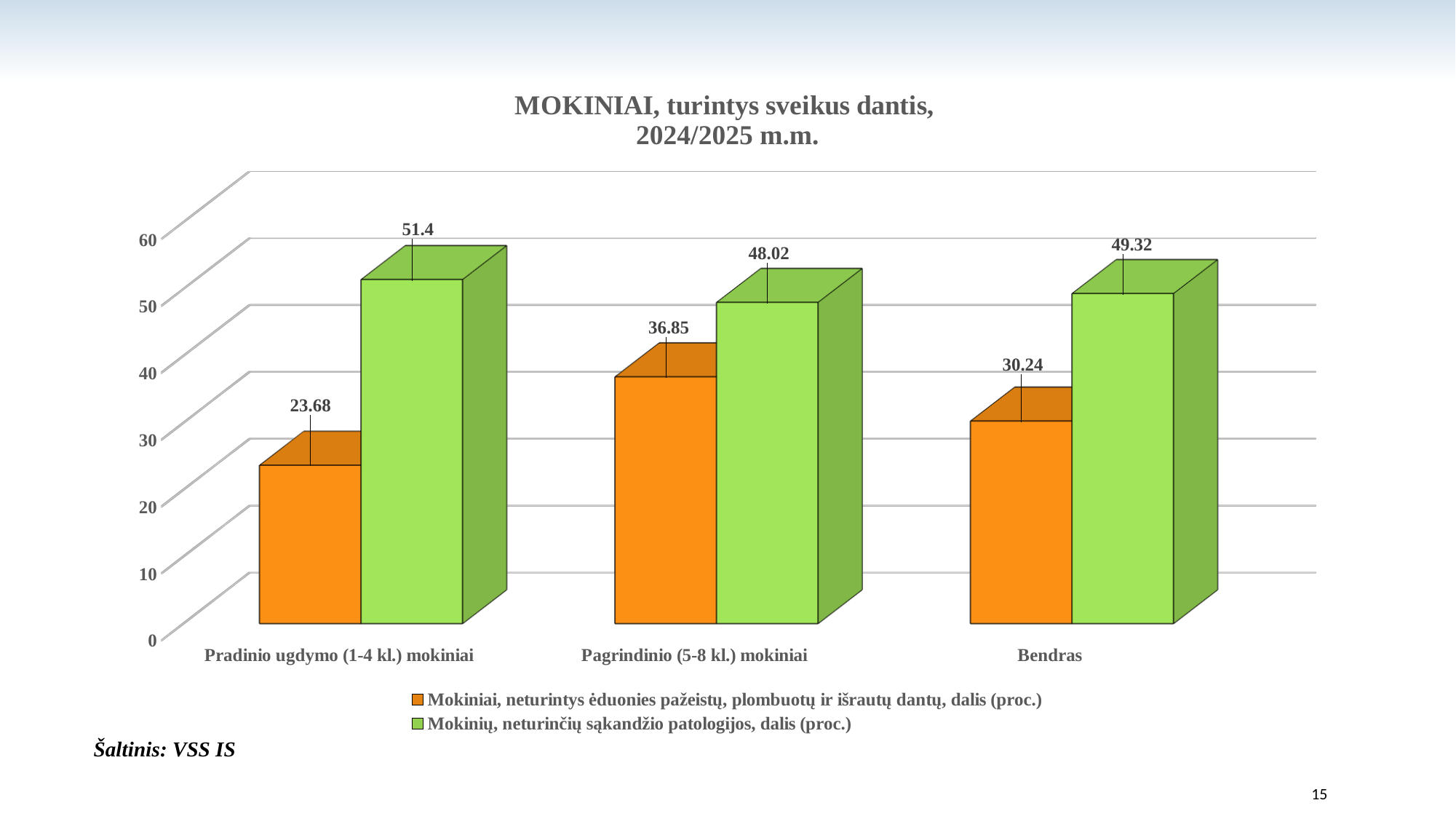
How many categories are shown on the x axis? 3 What is the difference between the 'Mokinių, neturinčių sąkandžio patologijos' values for Pradinio ugdymo (1-4 kl.) mokiniai and Pagrindinio (5-8 kl.) mokiniai? 3.38 What is the difference between the two series values for Pradinio ugdymo (1-4 kl.) mokiniai? 27.72 Which category has the lowest value in the series 'Mokiniai, neturintys ėduonies pažeistų, plombuotų ir išrautų dantų, dalis (proc.)'? Pradinio ugdymo (1-4 kl.) mokiniai What is the title of the chart? MOKINIAI, turintys sveikus dantis, 2024/2025 m.m. What kind of chart is shown on the slide? Bar chart Which category has the highest value in the series 'Mokinių, neturinčių sąkandžio patologijos, dalis (proc.)'? Pradinio ugdymo (1-4 kl.) mokiniai What is the value for Pagrindinio (5-8 kl.) mokiniai in the series 'Mokiniai, neturintys ėduonies pažeistų, plombuotų ir išrautų dantų, dalis (proc.)'? 36.85 What is the value for Pradinio ugdymo (1-4 kl.) mokiniai in the series 'Mokiniai, neturintys ėduonies pažeistų, plombuotų ir išrautų dantų, dalis (proc.)'? 23.68 What is the value for Bendras in the series 'Mokinių, neturinčių sąkandžio patologijos, dalis (proc.)'? 49.32 How many series does the legend list? 2 Which is larger: the 'Mokiniai, neturintys ėduonies pažeistų, plombuotų ir išrautų dantų' value for Pagrindinio (5-8 kl.) mokiniai or for Bendras? Pagrindinio (5-8 kl.) mokiniai